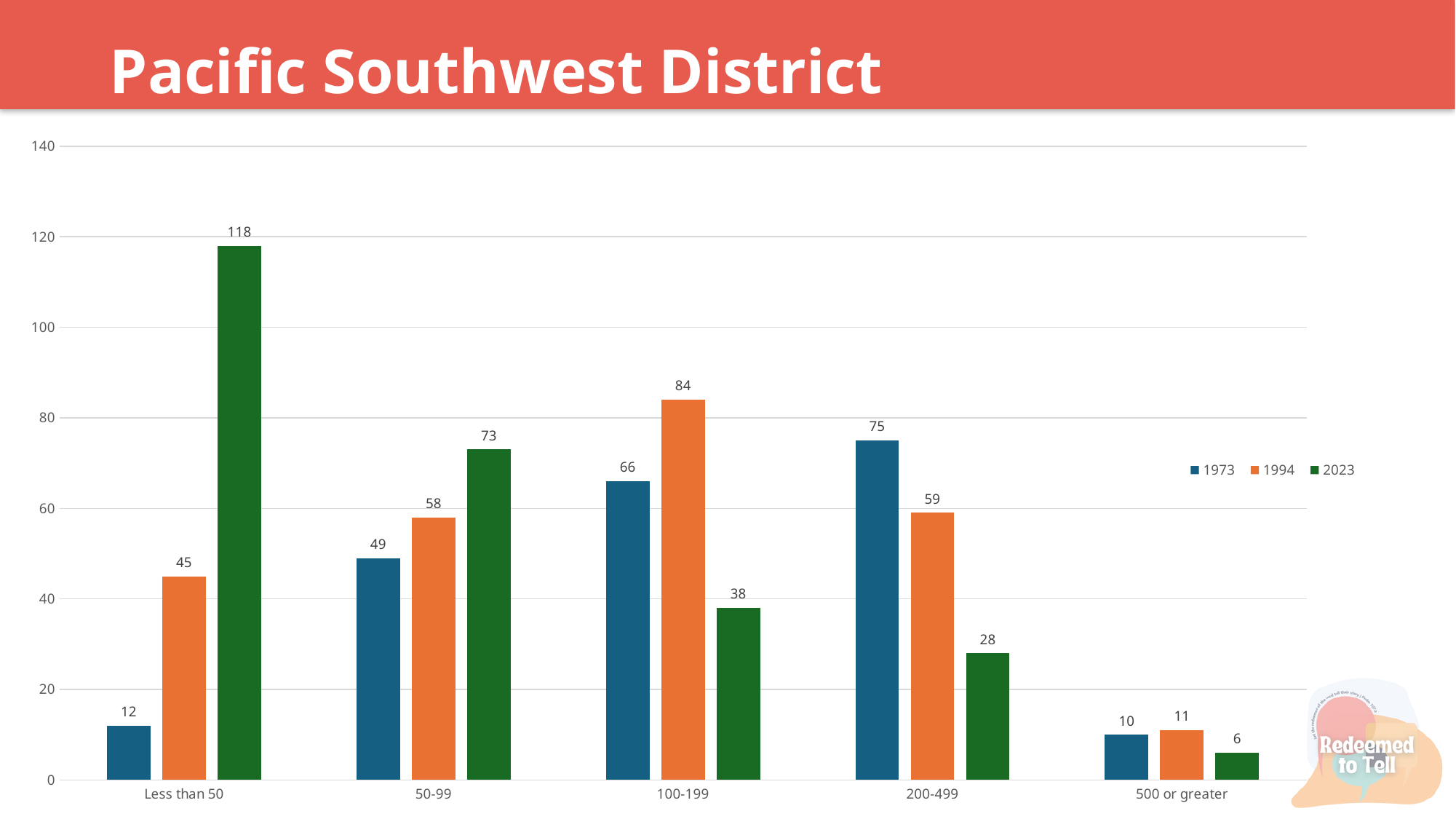
What kind of chart is shown on the slide? Bar chart Which category has the highest value for the 1973 series? 200-499 How many series does the legend list? 3 Which category has the lowest value for the 2023 series? 500 or greater Which is larger in the '100-199' category: the 1973 value or the 2023 value? 1973 What is the value for 2023 in the 'Less than 50' category? 118 What is the title of the slide? Pacific Southwest District How many categories are shown on the x axis? 5 What is the value for 1973 in the '200-499' category? 75 What is the value for 1994 in the '100-199' category? 84 What is the difference between the 2023 and 1973 values in the 'Less than 50' category? 106 Does the 2023 series rise or fall across the categories from 'Less than 50' to '500 or greater'? Fall